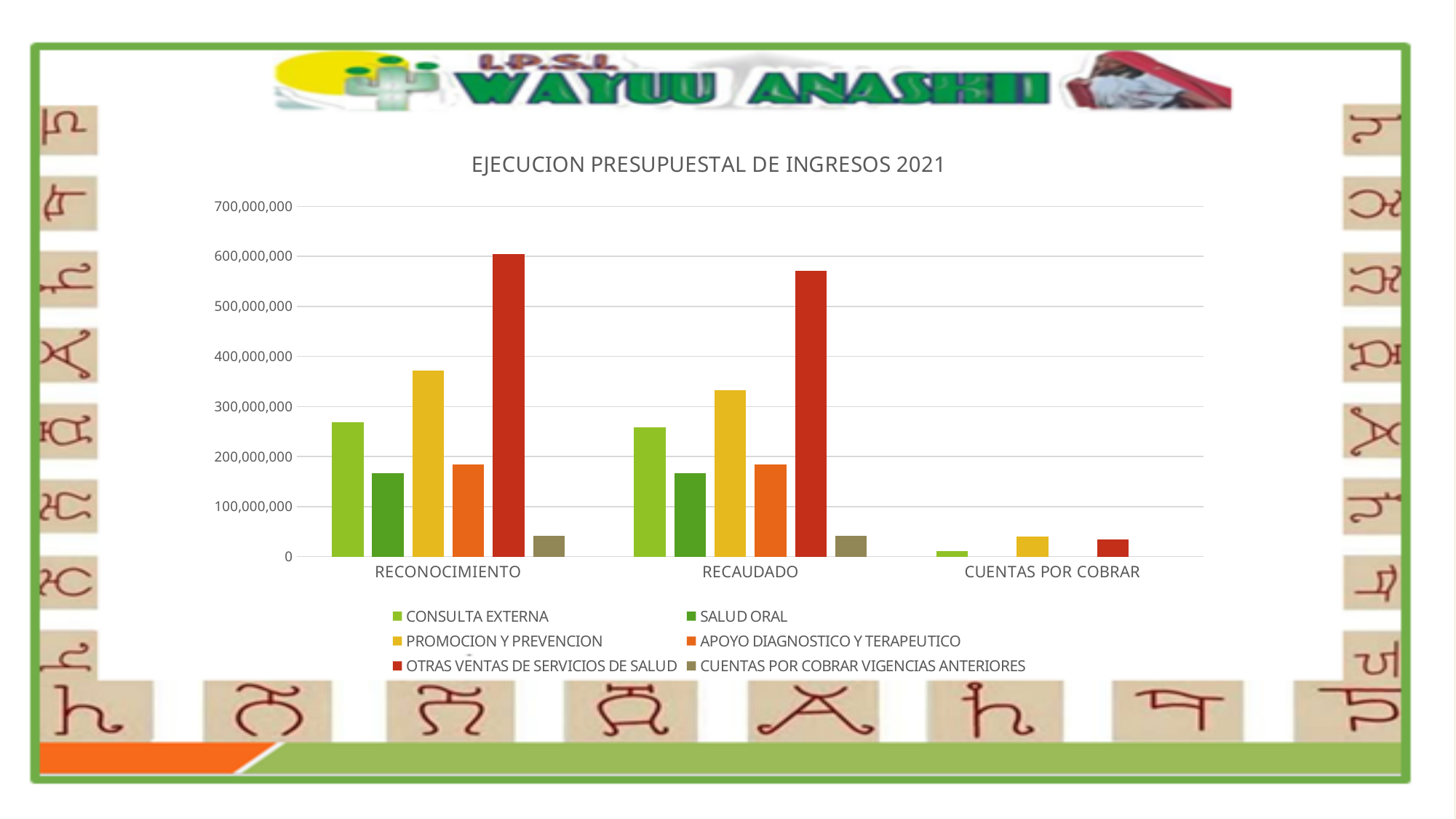
Is the value for SALUD ORAL in RECONOCIMIENTO greater or less than 200,000,000? less Which series has the highest value in the RECAUDADO category? OTRAS VENTAS DE SERVICIOS DE SALUD Which series has the highest value in the RECONOCIMIENTO category? OTRAS VENTAS DE SERVICIOS DE SALUD What kind of chart is shown on the slide? Bar chart What is the title of the chart? EJECUCION PRESUPUESTAL DE INGRESOS 2021 Which series has the lowest value in the RECONOCIMIENTO category? CUENTAS POR COBRAR VIGENCIAS ANTERIORES How many series does the legend list? 6 Is the value for OTRAS VENTAS DE SERVICIOS DE SALUD in RECONOCIMIENTO greater or less than 500,000,000? greater Is the value for PROMOCION Y PREVENCION in RECONOCIMIENTO greater or less than 400,000,000? less In the RECAUDADO category, which is larger: PROMOCION Y PREVENCION or APOYO DIAGNOSTICO Y TERAPEUTICO? PROMOCION Y PREVENCION How many categories are shown on the x axis? 3